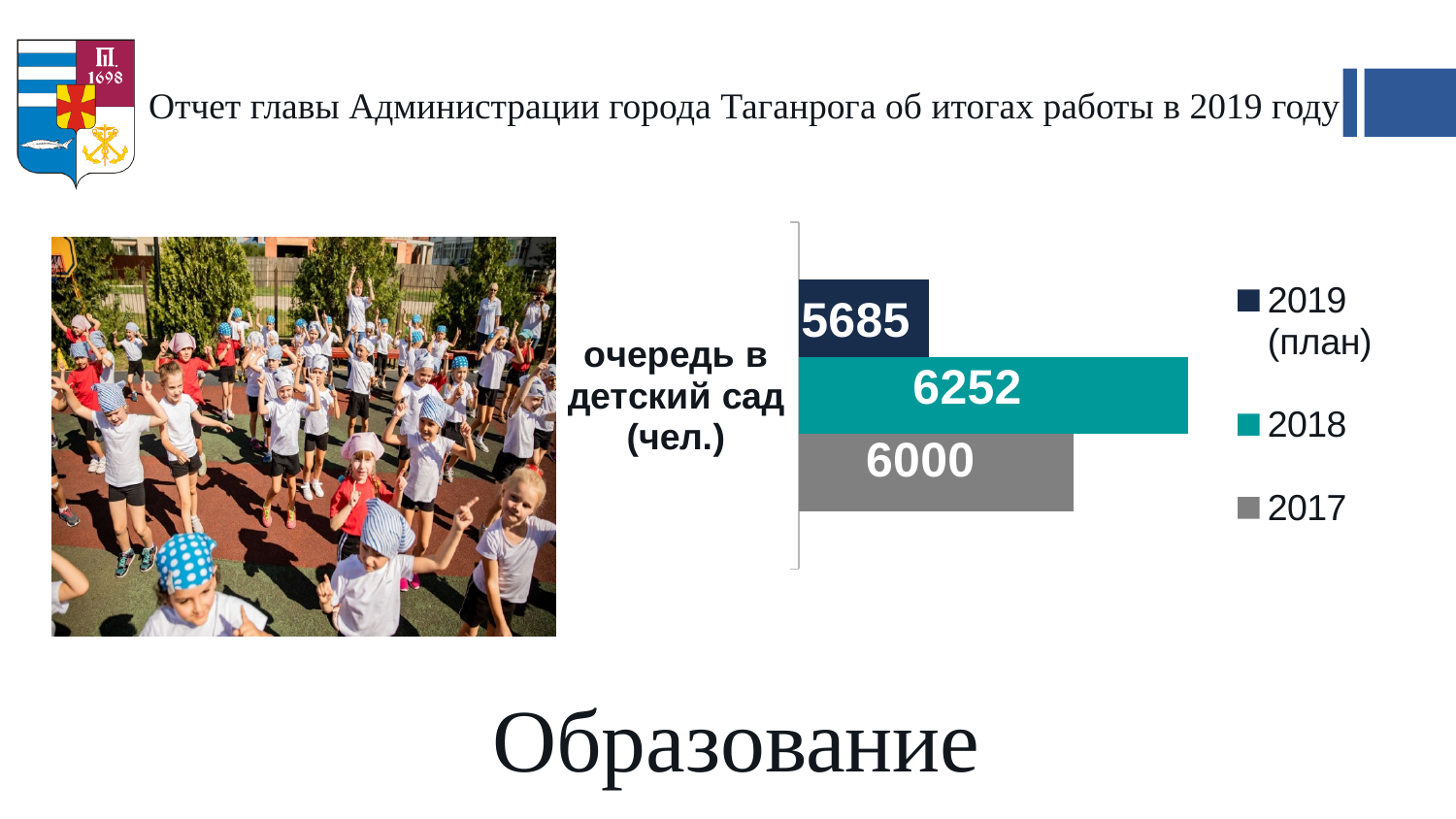
Which is larger in the kindergarten queue chart: the value for 2017 or the value for 2019 (план)? 2017 What kind of chart is used to show the kindergarten queue? bar chart What is the label next to the kindergarten queue chart? очередь в детский сад (чел.) What colour is the bar for 2018 in the kindergarten queue chart? teal What is the difference between the 2018 and 2019 (план) values in the kindergarten queue chart? 567 What is the value for 2019 (план) in the kindergarten queue chart? 5685 What is the value for 2018 in the kindergarten queue chart? 6252 What is the value for 2017 in the kindergarten queue chart? 6000 Which year has the lowest value in the kindergarten queue chart? 2019 (план) How many series does the legend of the kindergarten queue chart list? 3 What is the difference between the 2018 and 2017 values in the kindergarten queue chart? 252 Which year has the highest value in the kindergarten queue chart? 2018